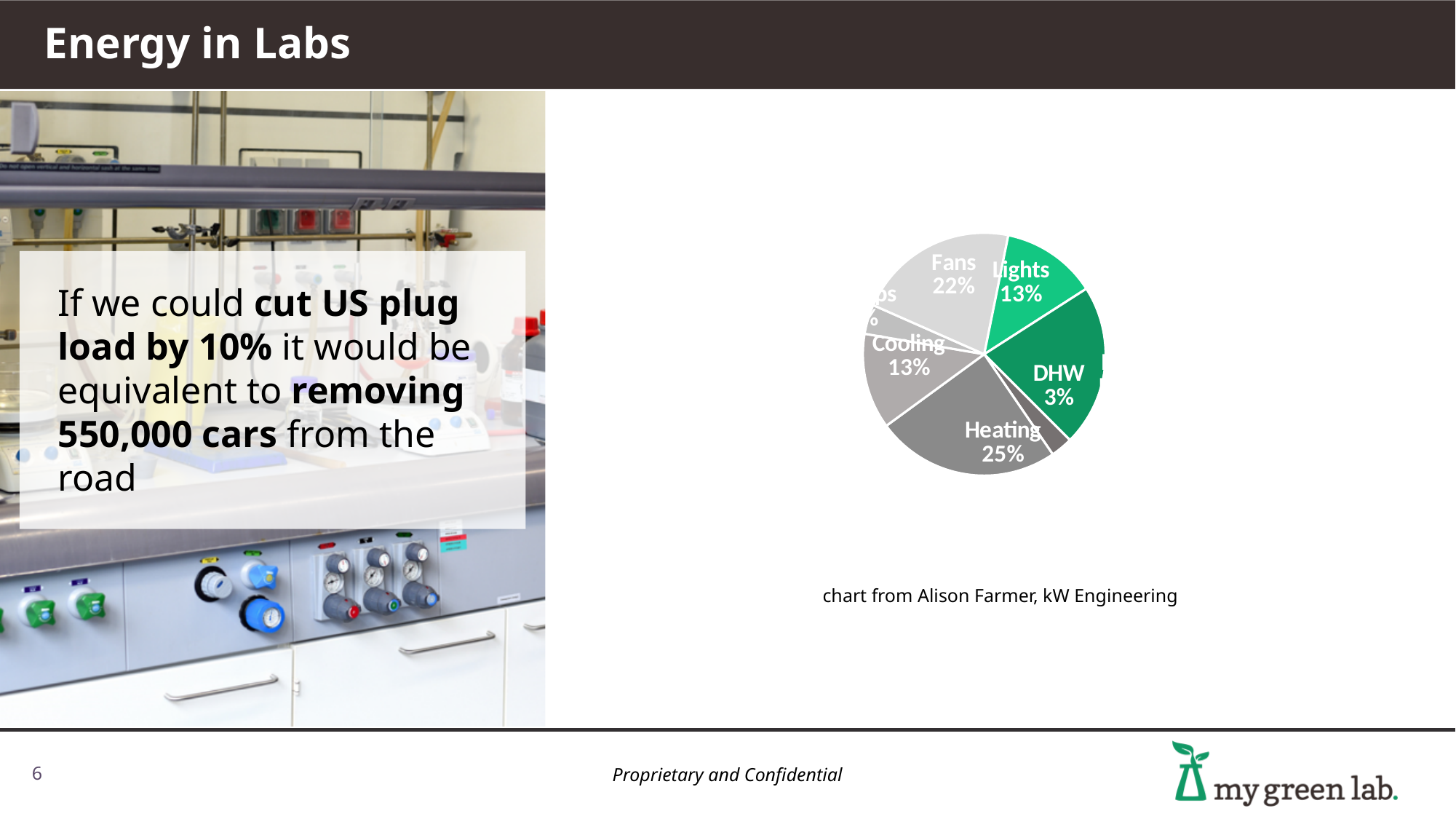
According to the caption, who is the chart from? Alison Farmer, kW Engineering Which is larger, the DHW slice or the Lights slice? Lights What percentage is shown for Fans? 22% What share of the pie does Heating account for? 25% What is the difference in percentage points between Fans and Cooling? 9% What percentage is shown for DHW? 3% What percentage is shown for Cooling? 13% What colour is the Lights slice of the pie? green What is the difference in percentage points between Heating and Fans? 3% Which is larger, the Fans slice or the Heating slice? Heating What kind of chart is shown on the slide? pie chart What percentage is shown for Lights? 13%